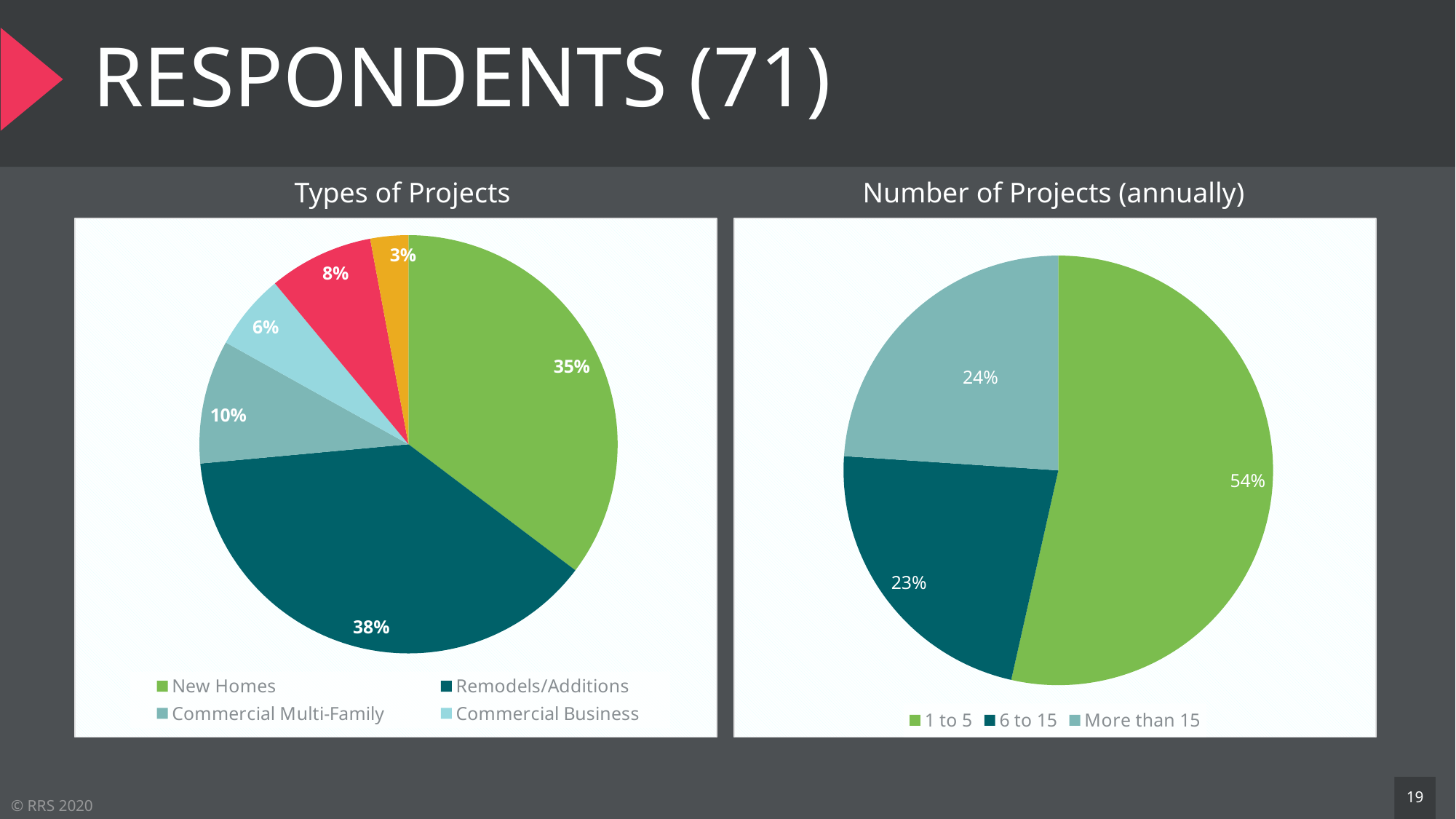
In the Types of Projects chart, which is larger, New Homes or Commercial Multi-Family? New Homes In the Types of Projects chart, what percentage is shown for Commercial Multi-Family? 10% In the Number of Projects (annually) chart, what percentage of respondents do 1 to 5 projects? 54% In the Types of Projects chart, what share of respondents do Remodels/Additions account for? 38% In the Types of Projects chart, which legend category has the largest slice? Remodels/Additions What type of chart is the Number of Projects (annually) chart? Pie chart In the Number of Projects (annually) chart, what percentage is shown for 6 to 15 projects? 23% In the Number of Projects (annually) chart, which category has the largest share? 1 to 5 In the Types of Projects chart, what percentage is shown for Commercial Business? 6% In the Number of Projects (annually) chart, what is the difference in percentage points between 1 to 5 and 6 to 15? 31 In the Types of Projects chart, what percentage is shown for New Homes? 35% In the Types of Projects chart, how many slices does the pie have? 6